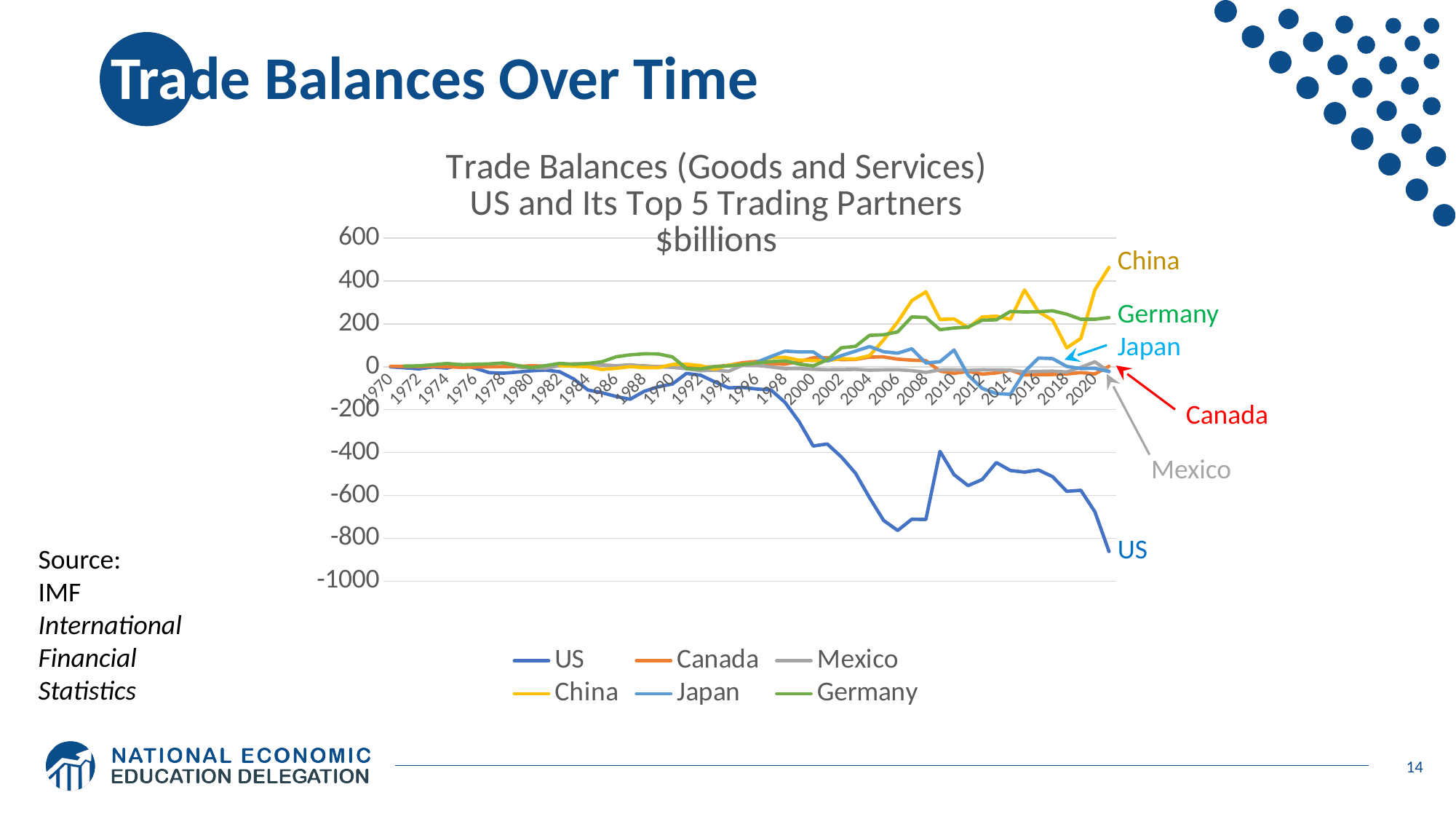
Is the value for China in 2008 greater or less than 200? greater What unit is stated in the chart title? $billions Which country's line has the lowest value in 2020? US In 2020, which is larger, the value for China or the value for Germany? China What kind of chart is shown on the slide? line chart Is the value for the US in 2020 greater or less than -800? greater What is the first year shown on the x axis? 1970 Is the value for the US in 2006 greater or less than -600? less Which country's line has the highest value in 2020? China How many series does the legend list? 6 Does the US line rise or fall between 1998 and 2006? fall